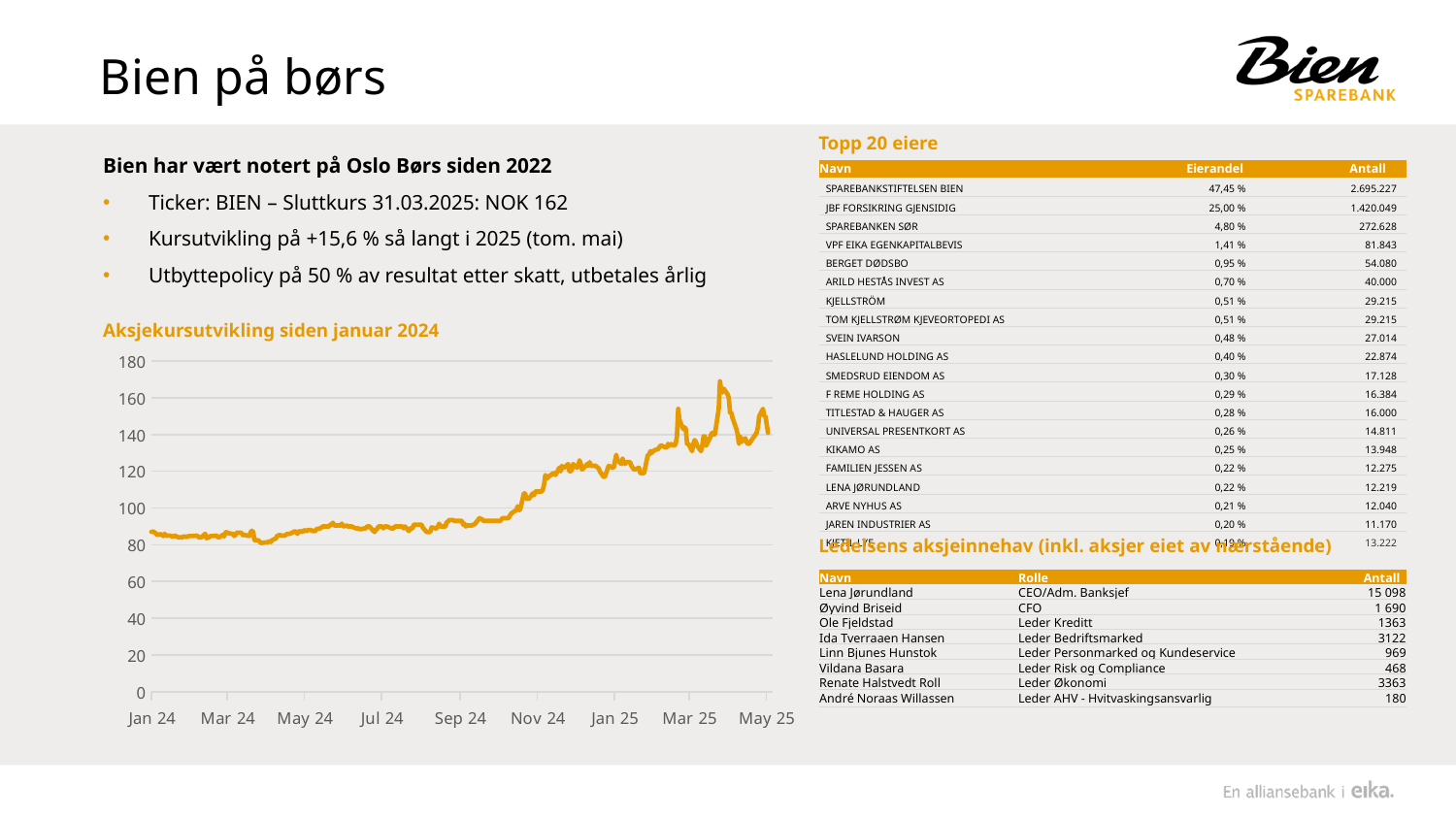
What is the title of the chart on the slide? Aksjekursutvikling siden januar 2024 Is the highest point of the line in the chart greater or less than 160? greater Is the value at May 24 in the chart greater or less than 100? less Is the value at Jan 24 in the chart greater or less than 100? less Which is higher in the chart, the value at Jan 24 or the value at Mar 25? Mar 25 How many date labels are shown on the x axis of the chart? 9 Overall, does the share price in the chart rise or fall from Jan 24 to May 25? rise What is the highest value shown on the y axis of the chart? 180 What kind of chart is "Aksjekursutvikling siden januar 2024"? line chart